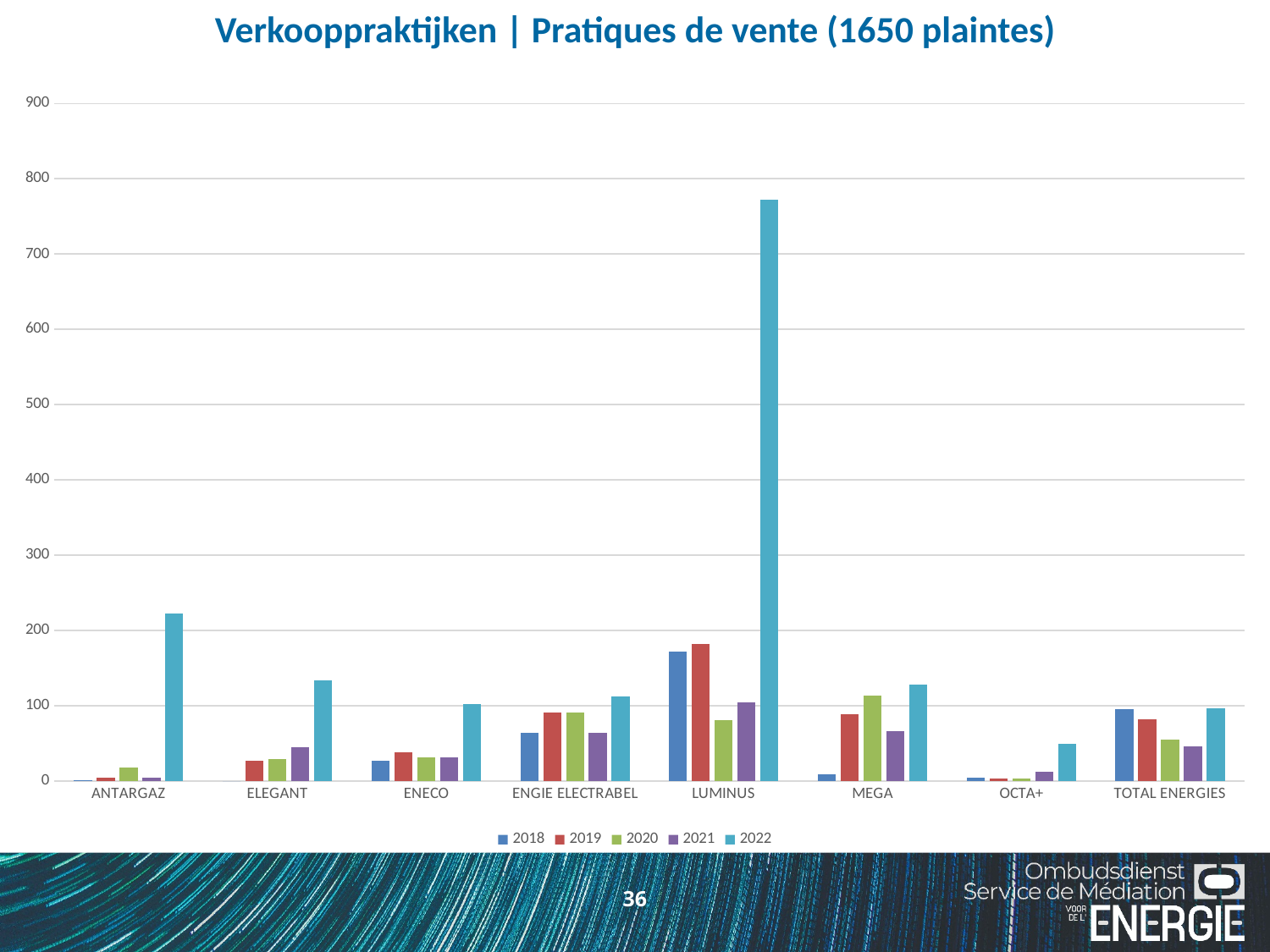
Which is larger for MEGA: the 2018 value or the 2019 value? 2019 Is the value for ANTARGAZ in 2022 greater or less than 200? greater Is the value for LUMINUS in 2022 greater or less than 700? greater How many suppliers (categories) are shown on the x axis? 8 How many series does the legend list? 5 Is the value for OCTA+ in 2022 greater or less than 100? less What is the title of the chart? Verkooppraktijken | Pratiques de vente (1650 plaintes) Which is larger: the 2022 value for ELEGANT or the 2022 value for ENECO? ELEGANT Which supplier has the highest bar for 2022? LUMINUS What kind of chart is shown on the slide? Bar chart Which supplier has the lowest bar for 2022? OCTA+